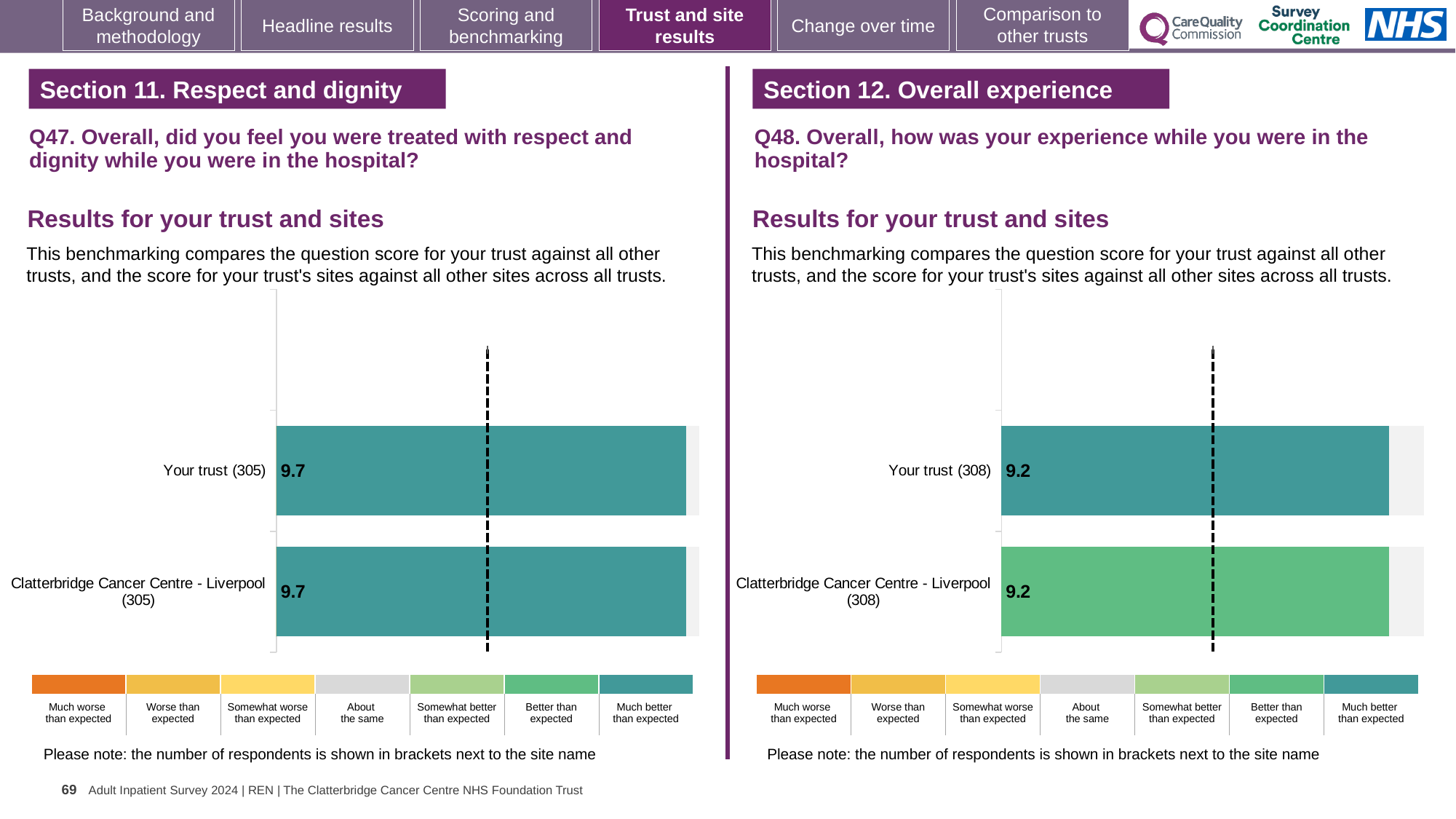
In the Q48 chart on the right, how many respondents are shown in brackets for Clatterbridge Cancer Centre - Liverpool? 308 In the Q48 chart on the right, what is the difference between the score for Your trust and the score for Clatterbridge Cancer Centre - Liverpool? 0 In the Q48 chart on the right, what is the score for Your trust? 9.2 What kind of chart is used for the Q47 results on the left? Bar chart In the Q48 chart on the right, what is the score for Clatterbridge Cancer Centre - Liverpool? 9.2 In the Q47 chart on the left, how many respondents are shown in brackets for Your trust? 305 In the Q47 chart on the left, what is the score for Clatterbridge Cancer Centre - Liverpool? 9.7 How many bars are plotted in the Q48 chart on the right? 2 In the Q47 chart on the left, what is the difference between the score for Your trust and the score for Clatterbridge Cancer Centre - Liverpool? 0 How many bars are plotted in the Q47 chart on the left? 2 In the Q47 chart on the left, what is the score for Your trust? 9.7 Is the score for Your trust in the Q47 chart on the left larger than, smaller than, or equal to the score for Your trust in the Q48 chart on the right? Larger